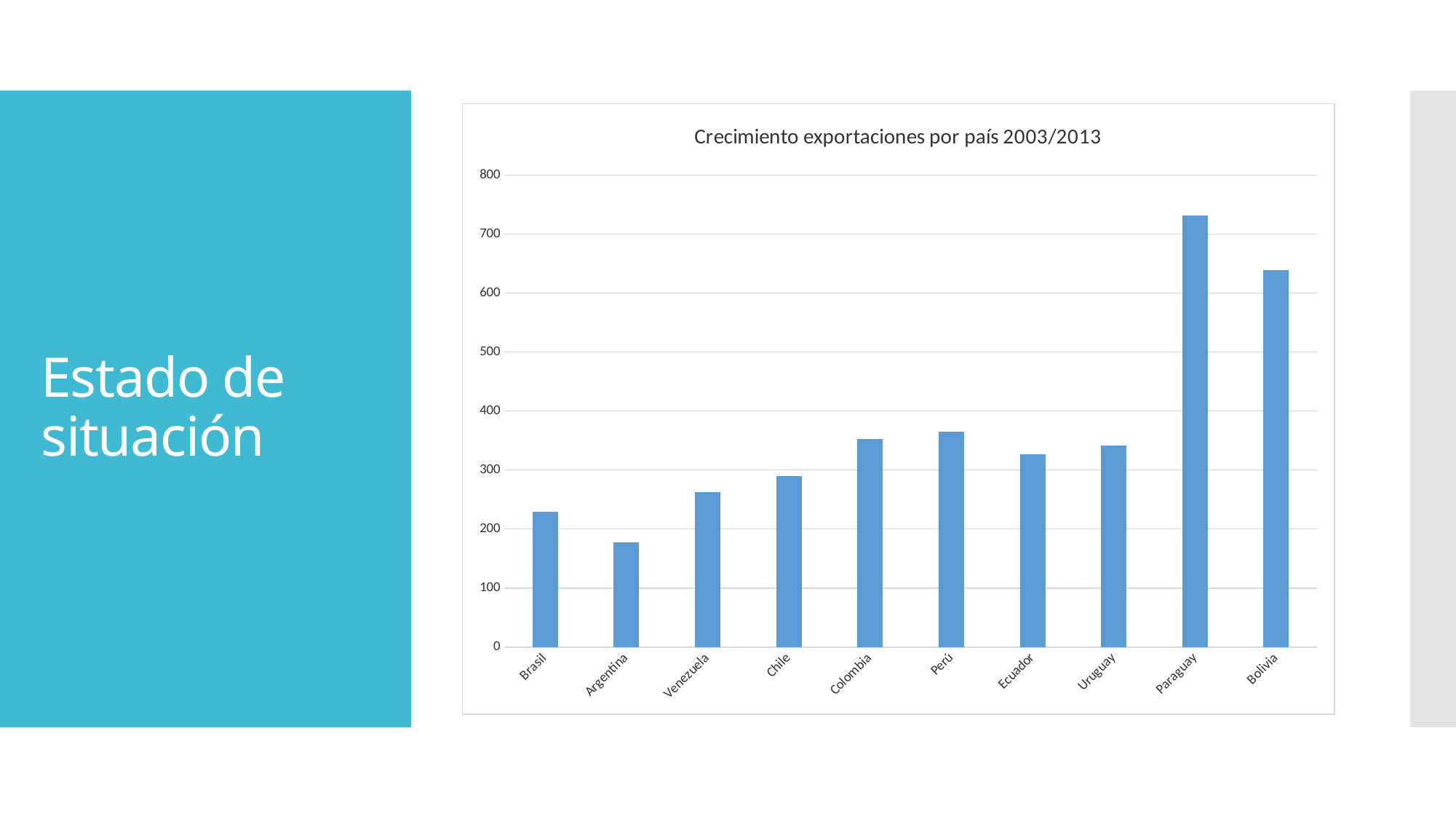
Is the value for Paraguay greater or less than 700? greater Which country has the highest value in the chart? Paraguay Is the value for Argentina greater or less than 200? less Is the value for Bolivia greater or less than 600? greater Which has a larger value, Paraguay or Bolivia? Paraguay What is the title of the chart? Crecimiento exportaciones por país 2003/2013 Which has a larger value, Chile or Venezuela? Chile How many countries are shown on the x axis of the chart? 10 Which country has the lowest value in the chart? Argentina What kind of chart is shown on the slide? bar chart Which has a larger value, Brasil or Argentina? Brasil